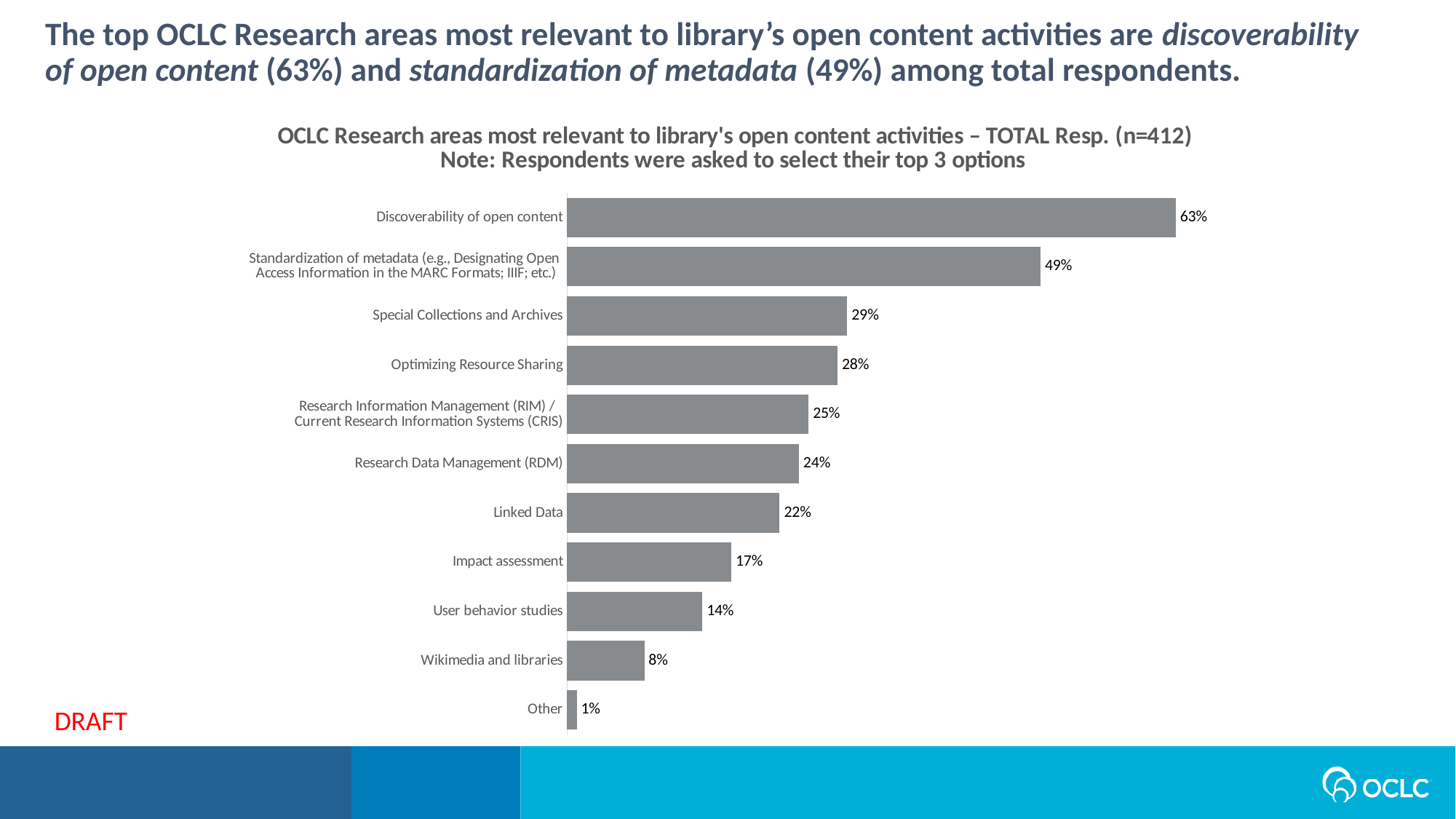
Which is larger, Special Collections and Archives or Research Data Management (RDM)? Special Collections and Archives Which category has the lowest percentage? Other What is the difference between Impact assessment and User behavior studies? 3% What is the value for Linked Data? 22% How many categories are shown in the chart? 11 What is the difference between Discoverability of open content and Standardization of metadata? 14% What is the sample size (n) stated in the chart title? 412 According to the chart note, how many options were respondents asked to select? Top 3 What percentage is shown for Wikimedia and libraries? 8% What percentage of respondents selected Discoverability of open content? 63% What kind of chart is shown on the slide? Bar chart Which research area has the highest percentage? Discoverability of open content